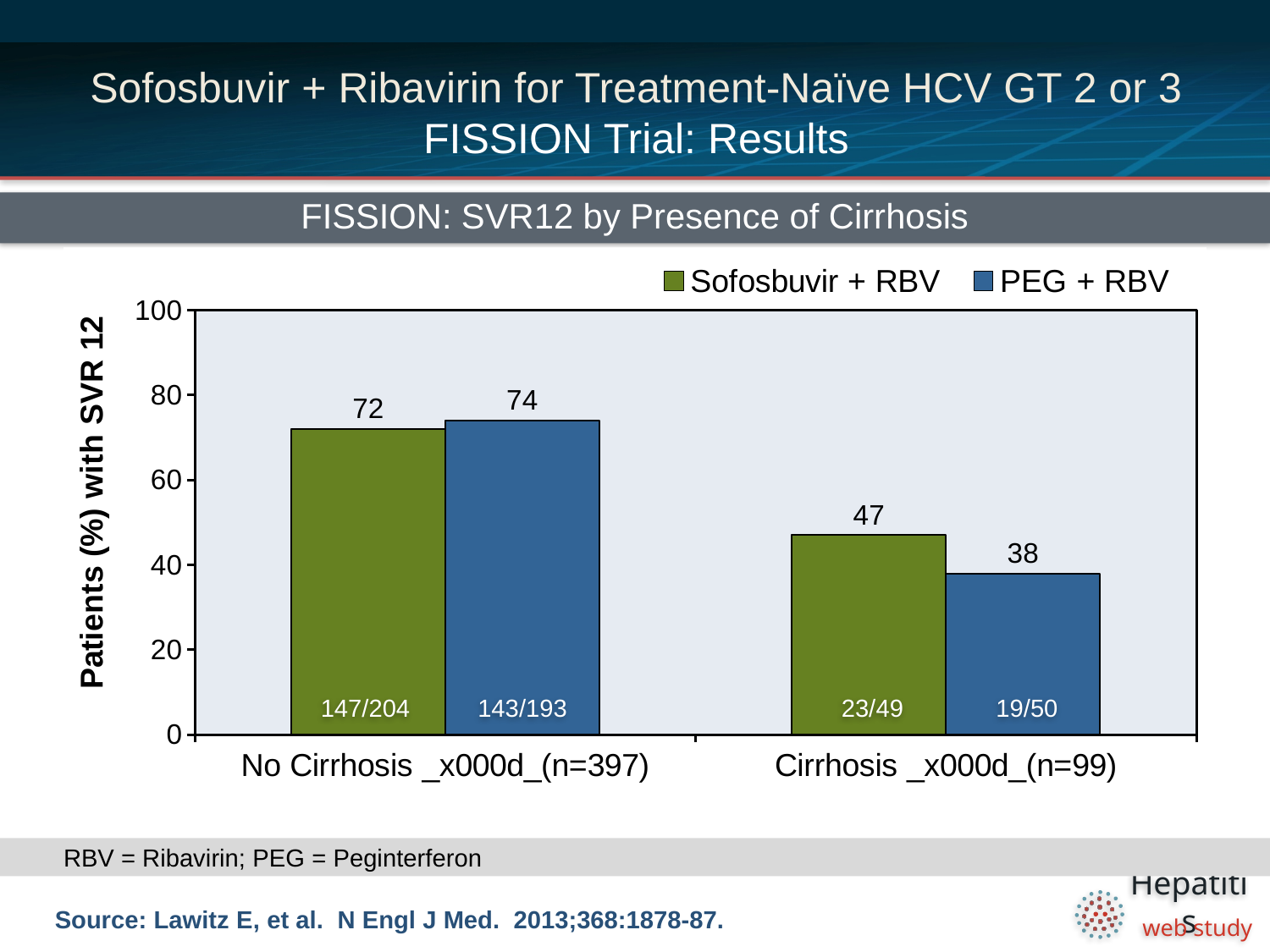
How many series does the legend list? 2 What is the difference between the Sofosbuvir + RBV and PEG + RBV values in the Cirrhosis group? 9 What is the SVR12 rate for Sofosbuvir + RBV in the Cirrhosis group? 47 Which bar has the highest value on the chart? PEG + RBV, No Cirrhosis (74) What fraction of patients is shown inside the PEG + RBV bar for the No Cirrhosis group? 143/193 Which bar has the lowest value on the chart? PEG + RBV, Cirrhosis (38) Is the value for Sofosbuvir + RBV in the Cirrhosis group greater or less than 60? less What is the label of the y axis? Patients (%) with SVR 12 In the Cirrhosis group, which treatment has the higher SVR12 rate? Sofosbuvir + RBV What is the SVR12 rate for Sofosbuvir + RBV in the No Cirrhosis group? 72 What kind of chart is shown on the slide? Bar chart What is the SVR12 rate for PEG + RBV in the Cirrhosis group? 38